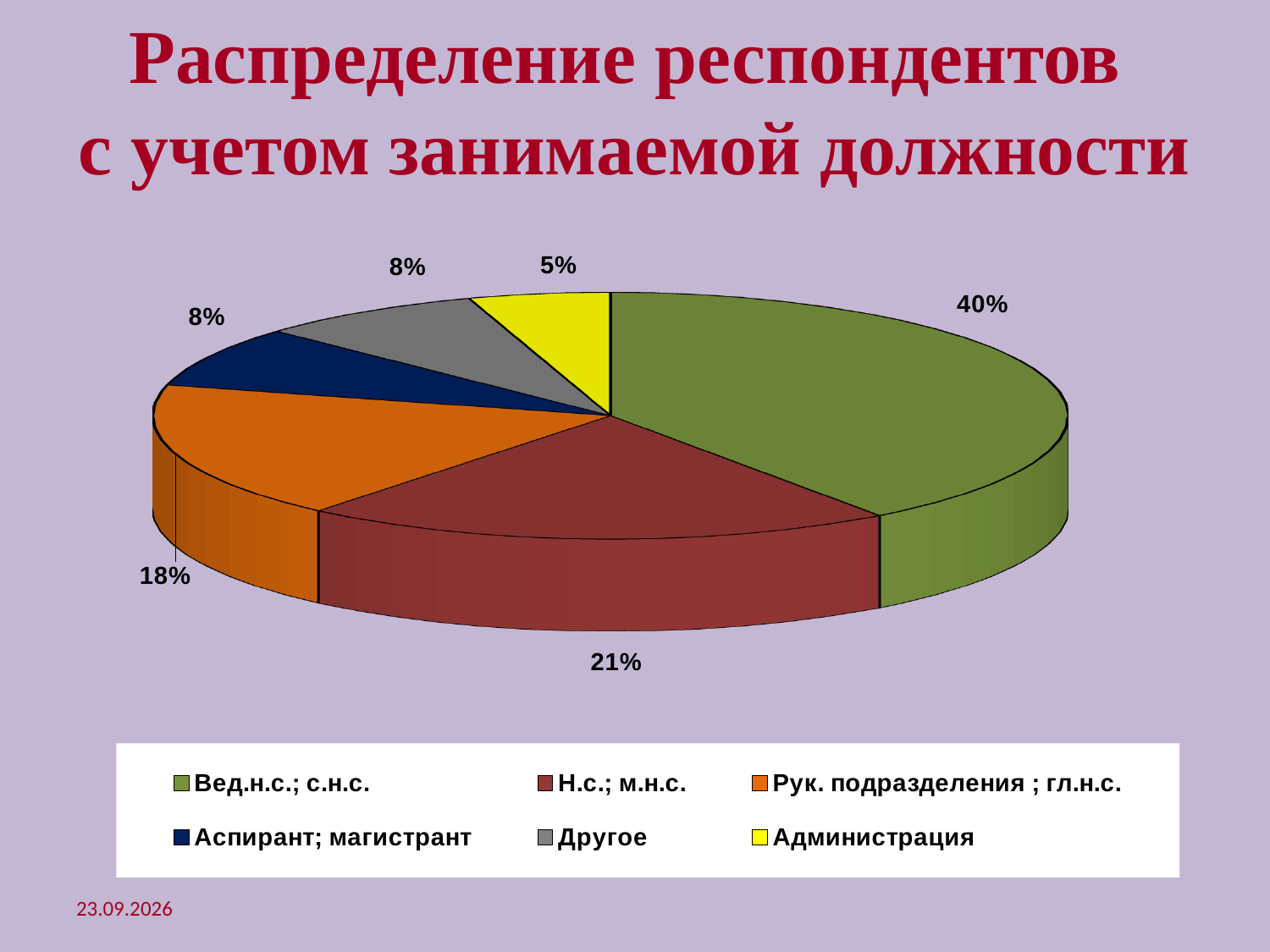
What share of respondents is shown for "Другое"? 8% What share of respondents is shown for "Вед.н.с.; с.н.с."? 40% What colour is the slice for "Администрация"? yellow Which category has the smallest slice of the pie? Администрация What share of respondents is shown for "Рук. подразделения ; гл.н.с."? 18% What kind of chart is shown on the slide? pie chart What is the difference in percentage points between "Вед.н.с.; с.н.с." and "Н.с.; м.н.с."? 19 Which category has the largest slice of the pie? Вед.н.с.; с.н.с. How many categories does the legend list? 6 Which is larger, the share for "Н.с.; м.н.с." or the share for "Рук. подразделения ; гл.н.с."? Н.с.; м.н.с.